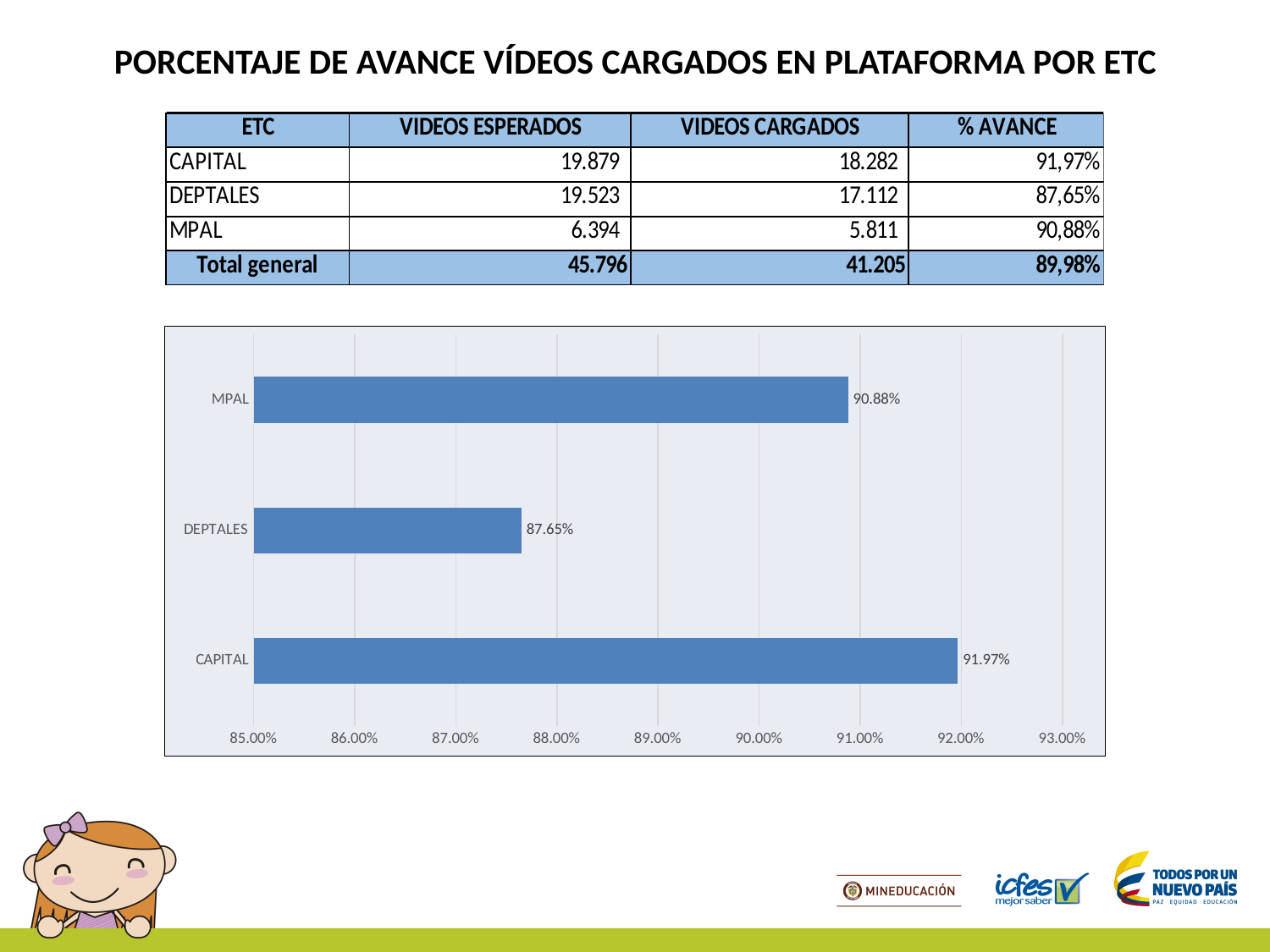
How many categories are shown in the bar chart? 3 What is the lowest value shown on the x axis of the bar chart? 85.00% What is the value for DEPTALES in the bar chart? 87.65% Which is larger in the bar chart, the value for MPAL or the value for DEPTALES? MPAL What kind of chart is shown on the slide? bar chart What is the value for MPAL in the bar chart? 90.88% What is the difference between the values for CAPITAL and MPAL in the bar chart? 1.09% Which category has the highest value in the bar chart? CAPITAL What is the difference between the values for CAPITAL and DEPTALES in the bar chart? 4.32% What is the value for CAPITAL in the bar chart? 91.97% Is the value for DEPTALES in the bar chart greater or less than 88.00%? less Which category has the lowest value in the bar chart? DEPTALES